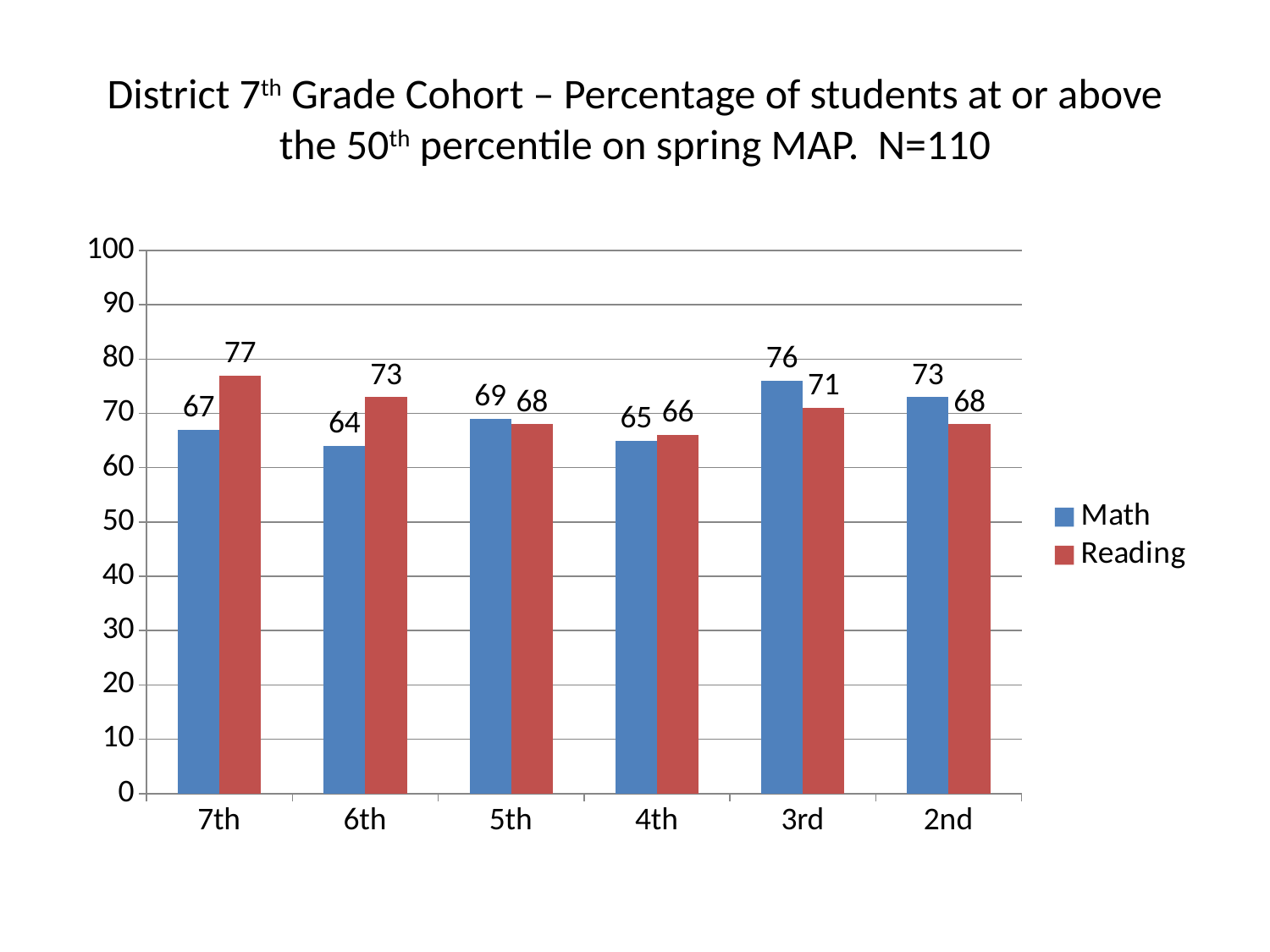
Which category has the lowest Reading value? 4th Which category has the highest Math value? 3rd What is the Reading value for 6th? 73 What colour are the Reading bars? red What is the Math value for 3rd? 76 How many categories are shown on the x axis? 6 What is the Math value for 7th? 67 Is the Math value for 6th greater or less than 70? less What kind of chart is shown on the slide? bar chart Which is larger for 2nd, Math or Reading? Math How many series does the legend list? 2 What is the difference between the Reading and Math values for 7th? 10